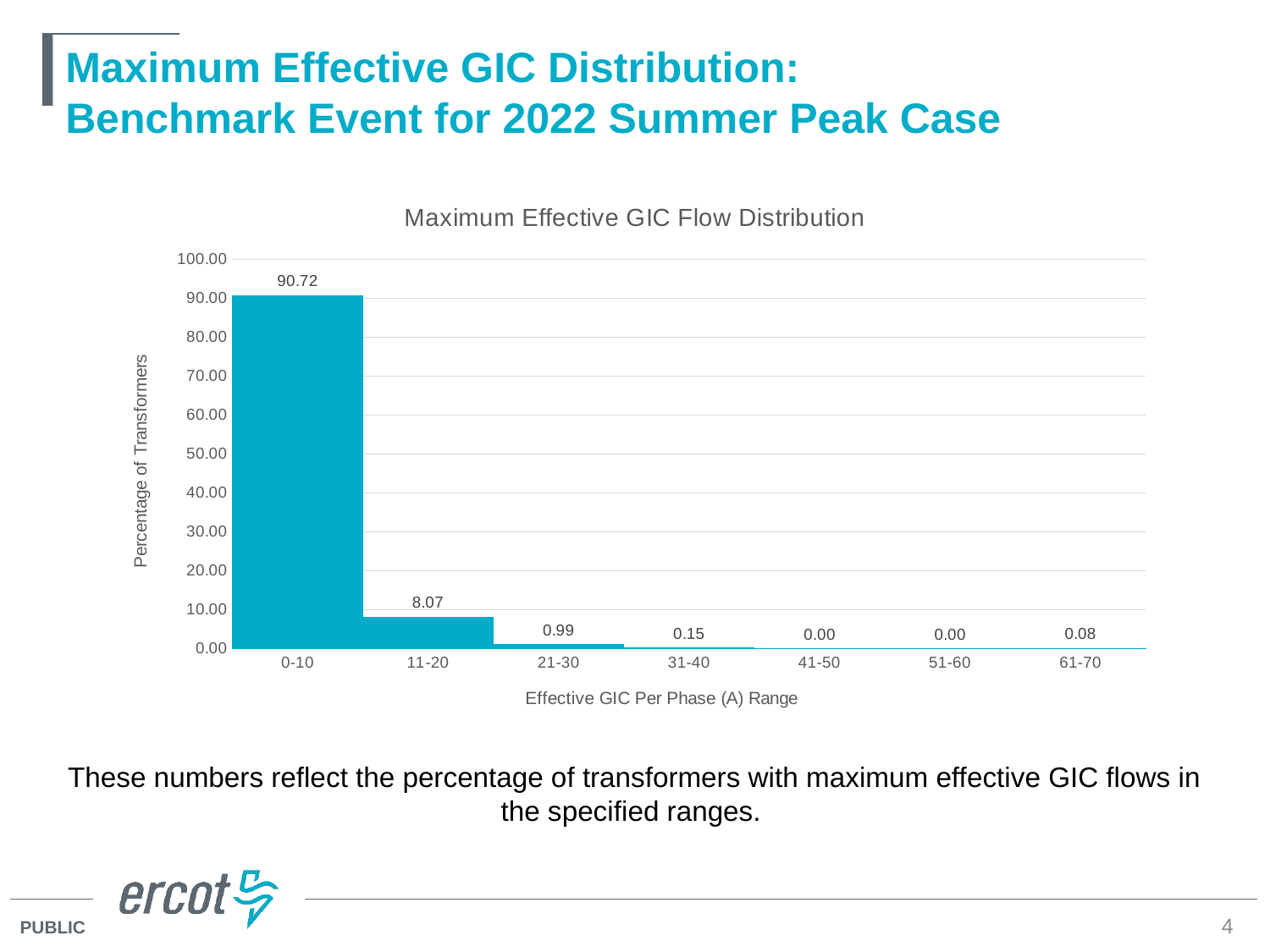
Do the values rise or fall from the 0-10 range to the 21-30 range? fall Which range has the highest percentage of transformers? 0-10 What kind of chart is shown? bar chart What is the value for the 61-70 range? 0.08 Which is larger, the value for 31-40 or the value for 61-70? 31-40 What is the difference between the values for the 0-10 and 11-20 ranges? 82.65 Is the value for the 0-10 range greater or less than 80.00? greater What is the value for the 21-30 range? 0.99 How many ranges are shown on the x axis? 7 What is the value for the 0-10 range? 90.72 What is the title of the chart? Maximum Effective GIC Flow Distribution What is the value for the 11-20 range? 8.07